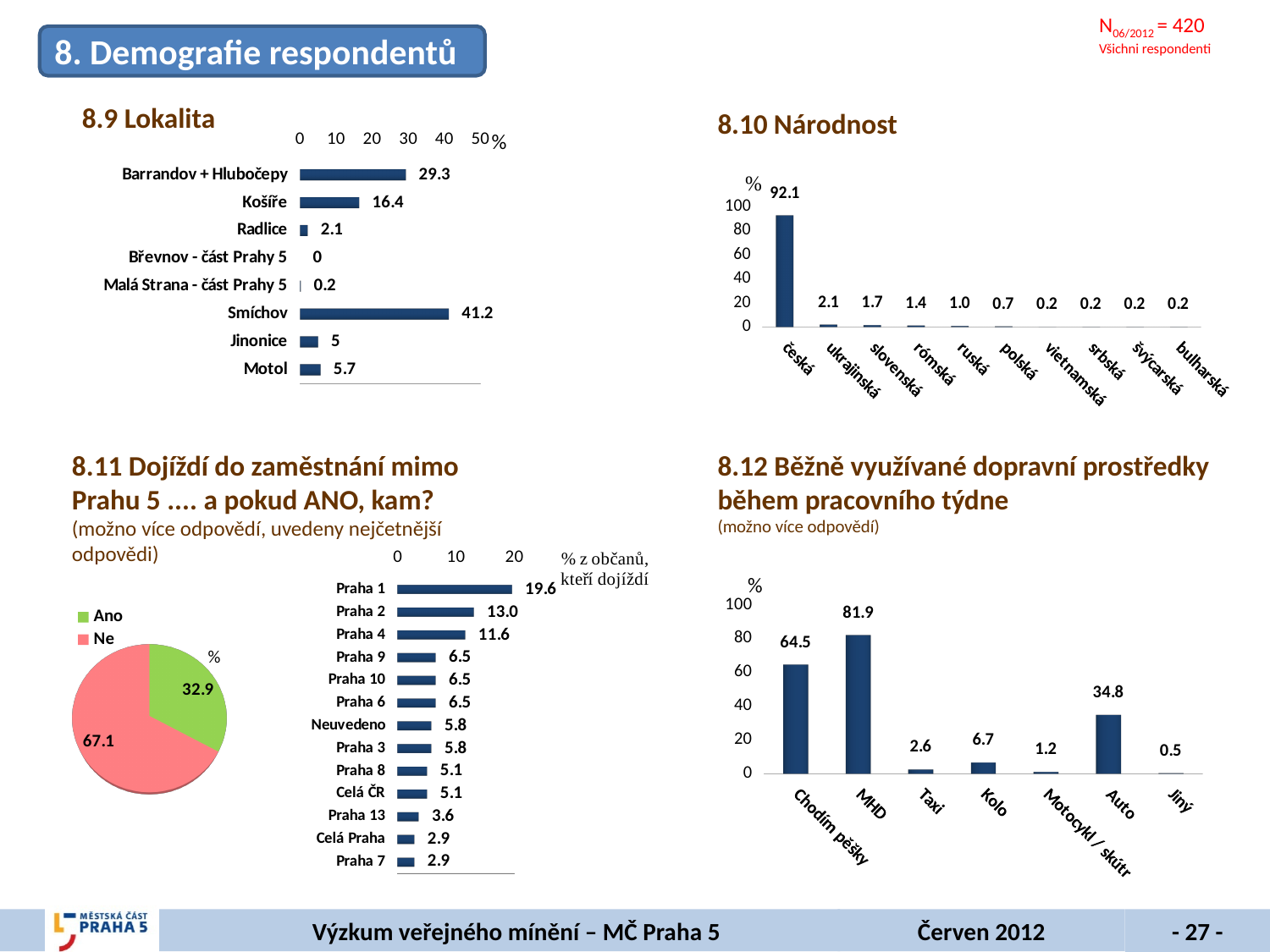
In the 8.11 pie chart, what share of respondents answered Ano? 32.9 In the 8.10 Národnost chart, what is the value for česká? 92.1 In the 8.9 Lokalita chart, how many localities are listed? 8 In the 8.10 Národnost chart, how many nationality categories are shown? 10 In the 8.12 chart, what is the value for MHD? 81.9 What type of chart is the 8.12 Běžně využívané dopravní prostředky chart? bar chart In the 8.9 Lokalita chart, which locality has the highest value? Smíchov In the 8.9 Lokalita chart, what is the value for Smíchov? 41.2 In the 8.11 bar chart of destinations, what is the value for Praha 2? 13.0 In the 8.9 Lokalita chart, what is the difference between Barrandov + Hlubočepy and Košíře? 12.9 In the 8.10 Národnost chart, which is larger, ukrajinská or slovenská? ukrajinská In the 8.11 bar chart of destinations, which destination has the highest value? Praha 1